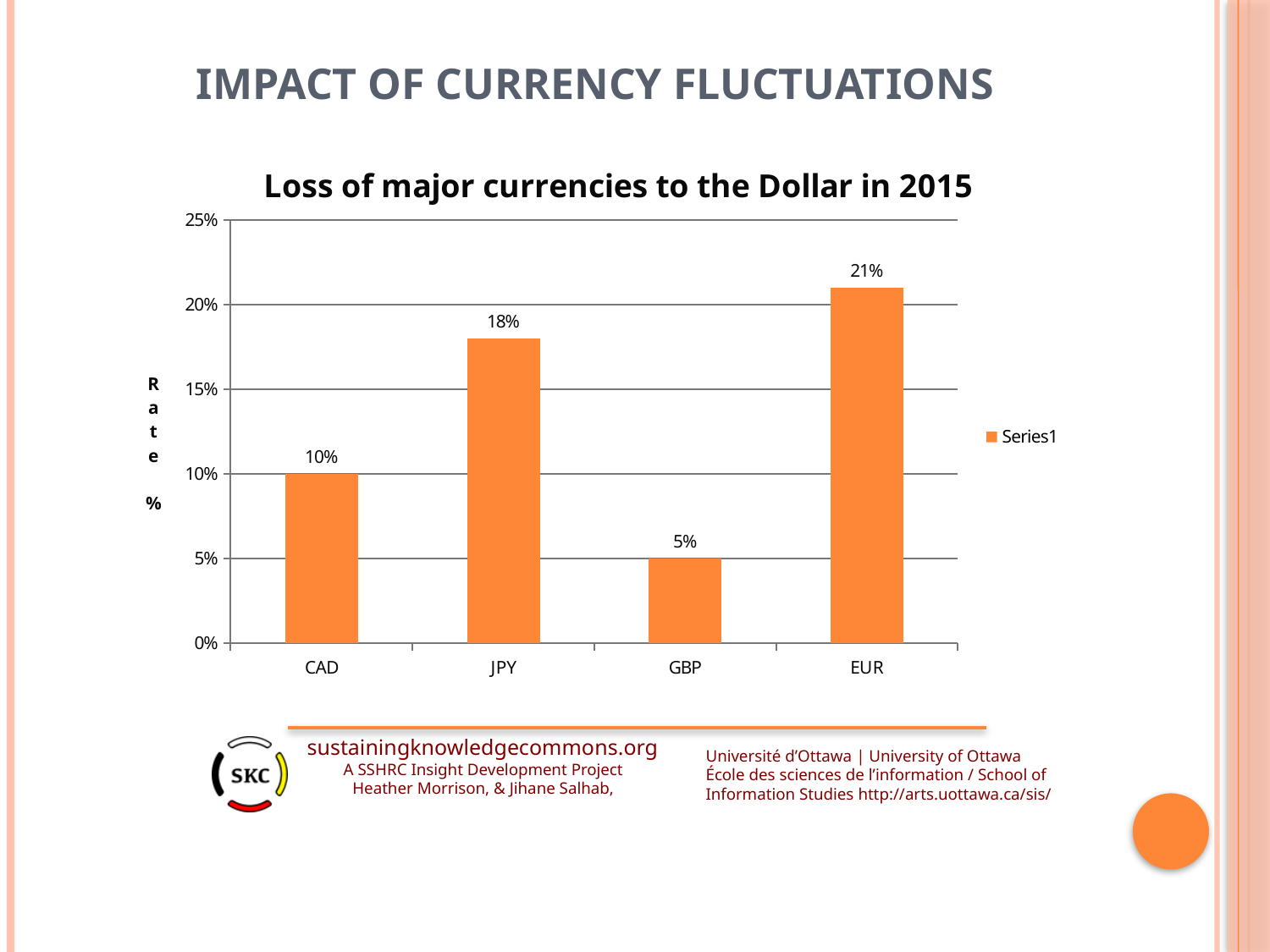
Which currency has the highest loss to the Dollar in 2015? EUR Which has a larger loss rate, JPY or GBP? JPY What is the loss rate shown for CAD? 10% How many currencies are shown on the x axis? 4 What is the loss rate shown for GBP? 5% Which currency has the lowest loss to the Dollar in 2015? GBP What kind of chart is shown on the slide? Bar chart What is the difference between the loss rates for EUR and CAD? 11% What is the title of the chart? Loss of major currencies to the Dollar in 2015 What is the loss rate shown for JPY? 18% What is the loss rate shown for EUR? 21% Is the value for JPY greater or less than 15%? greater